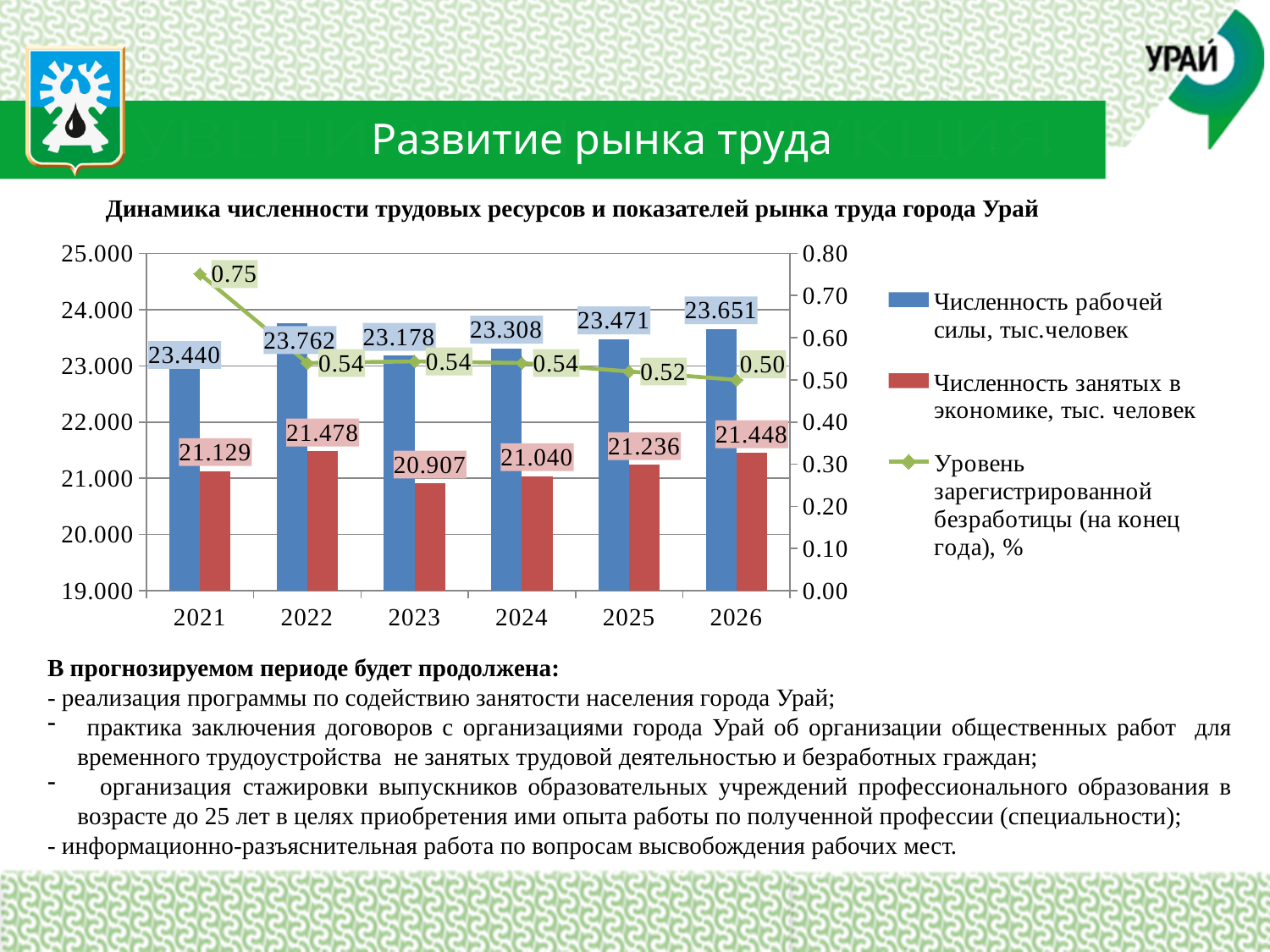
Which year has the larger value for 'Численность занятых в экономике': 2022 or 2025? 2022 What is the value of 'Численность рабочей силы, тыс.человек' for 2024? 23.308 In which year is 'Численность занятых в экономике, тыс. человек' lowest? 2023 How many years are shown on the x axis of the chart? 6 What is the registered unemployment rate ('Уровень зарегистрированной безработицы') shown for 2021? 0.75 Does the registered unemployment rate line rise or fall from 2021 to 2026? Fall How many series does the chart legend list? 3 In which year is 'Численность рабочей силы, тыс.человек' highest? 2022 What is the value of 'Численность занятых в экономике, тыс. человек' for 2023? 20.907 What is the difference between 'Численность рабочей силы' and 'Численность занятых в экономике' in 2021? 2.311 By how much does the registered unemployment rate fall from 2021 to 2026? 0.25 What kind of chart is shown on the slide? Combination bar and line chart